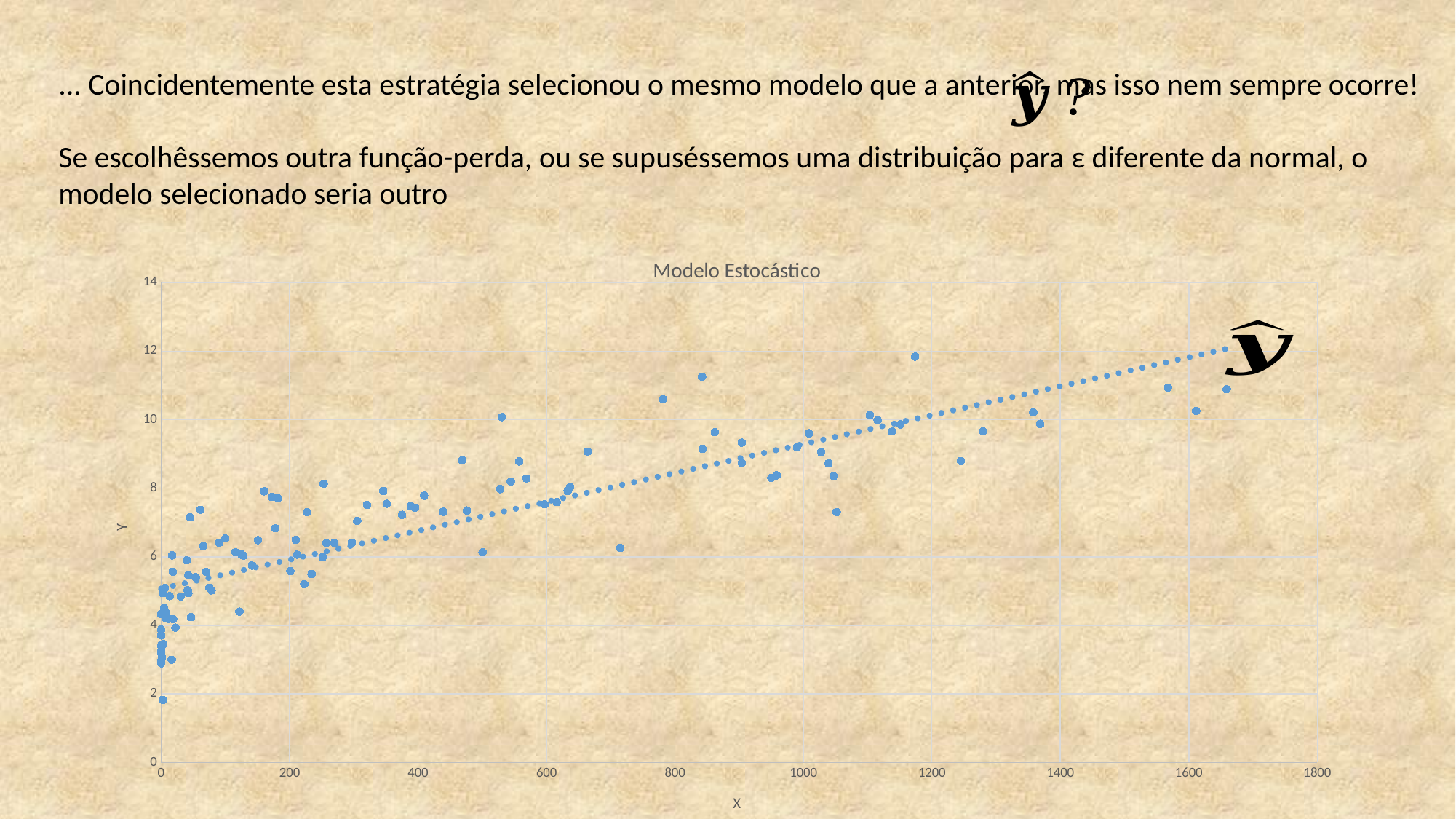
What is the label of the horizontal axis of the chart? X Is the Y value of the highest point near X = 1200 greater or less than 10? greater What kind of chart is shown on the slide? scatter chart Do the plotted Y values generally rise or fall as X increases? rise What is the maximum value shown on the Y axis? 14 Is the Y value of the isolated point near X = 700 greater or less than 8? less What is the title of the chart? Modelo Estocástico Is the Y value of the lowest point near X = 0 greater or less than 4? less